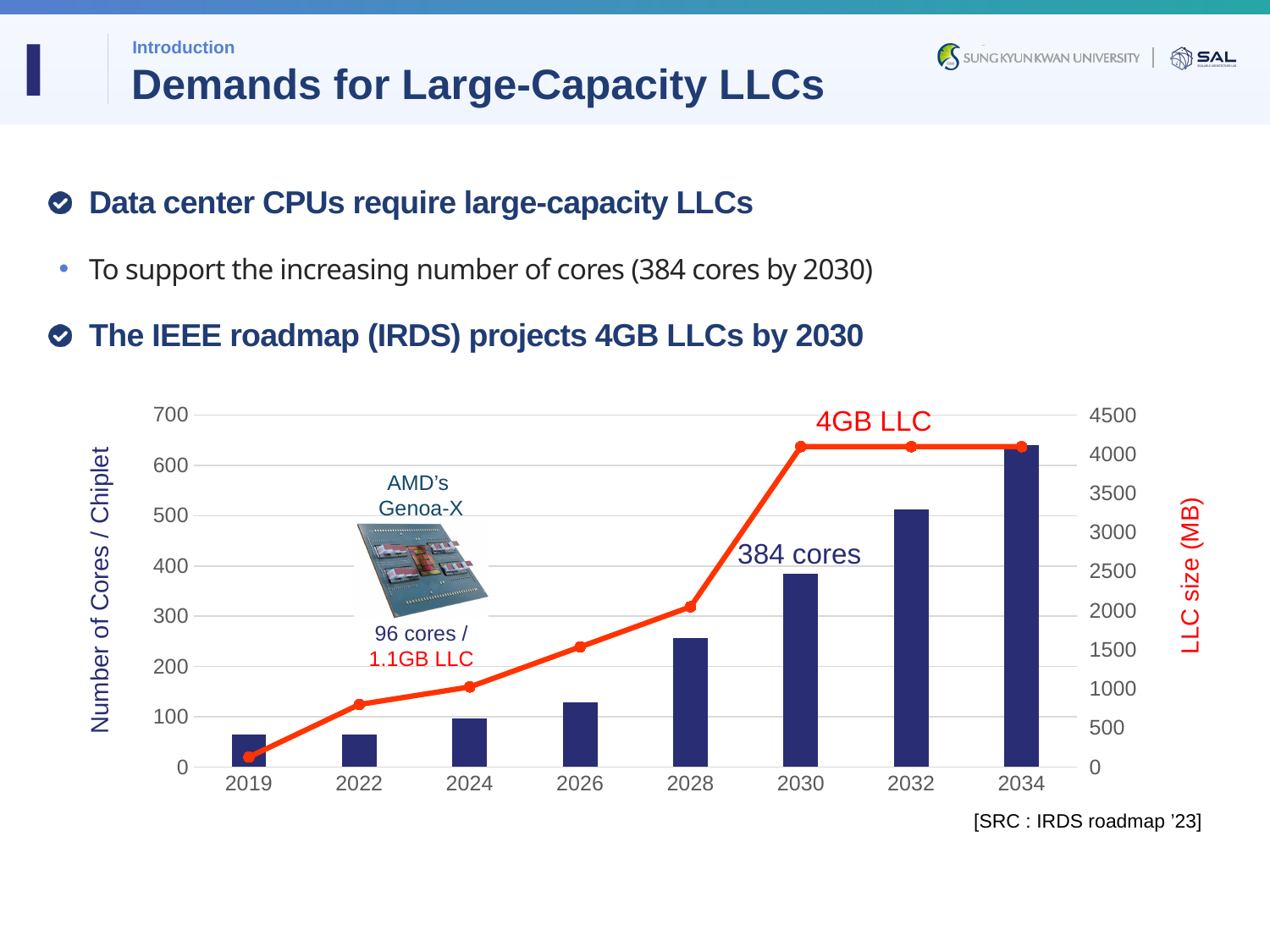
Do the bars for number of cores per chiplet rise or fall from 2019 to 2034? rise What is the label of the right-hand vertical axis of the chart? LLC size (MB) How many years are shown on the x axis of the chart? 8 Which year has the tallest bar for number of cores per chiplet? 2034 Which year has a larger number of cores per chiplet, 2028 or 2032? 2032 Is the number of cores per chiplet for 2028 greater or less than 300? less What kind of chart is shown on the slide? A bar chart combined with a line chart According to the chart annotation, what LLC size is projected for 2030? 4GB LLC According to the chart annotation, how many cores per chiplet are projected for 2030? 384 cores Is the number of cores per chiplet for 2032 greater or less than 400? greater Is the LLC size for 2028 greater or less than 2500 MB? less